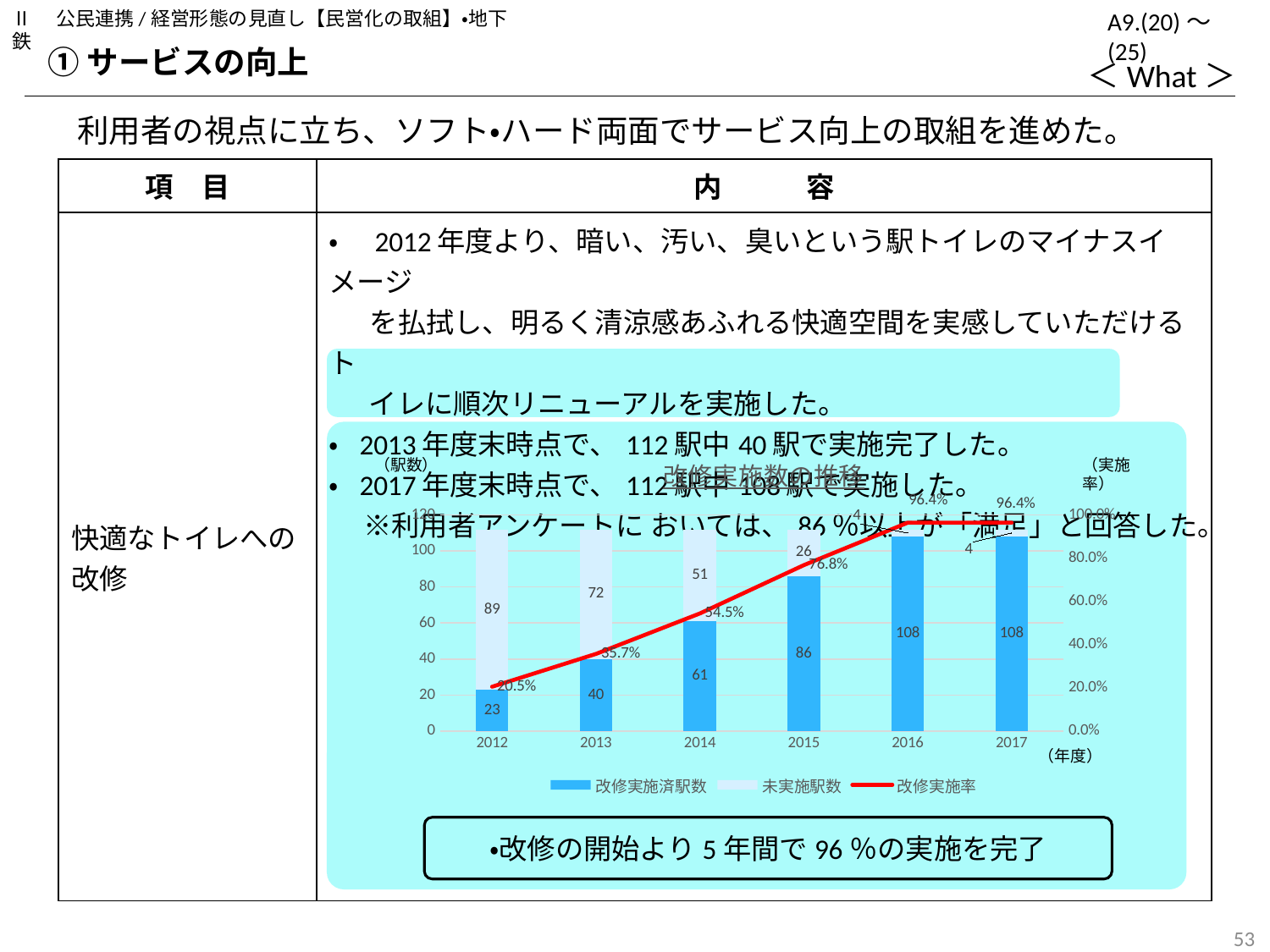
How many years are shown on the x axis of the chart? 6 Which is larger, the number of renovated stations in 2014 or the number of stations not yet renovated in 2014? Renovated stations (61) How many series does the chart legend list? 3 What is the difference in the number of renovated stations (改修実施済駅数) between 2015 and 2013? 46 What is the renovation implementation rate (改修実施率) in 2014? 54.5% What is the number of stations not yet renovated (未実施駅数) in 2013? 72 In which year is the renovation implementation rate (改修実施率) the lowest? 2012 What is the renovation implementation rate (改修実施率) in 2017? 96.4% Does the renovation implementation rate (改修実施率) rise or fall from 2012 to 2016? Rise What is the total height of the stacked bar for 2015 (renovated plus not yet renovated stations)? 112 In which year is the number of stations not yet renovated (未実施駅数) the highest? 2012 What is the number of renovated stations (改修実施済駅数) in 2012? 23